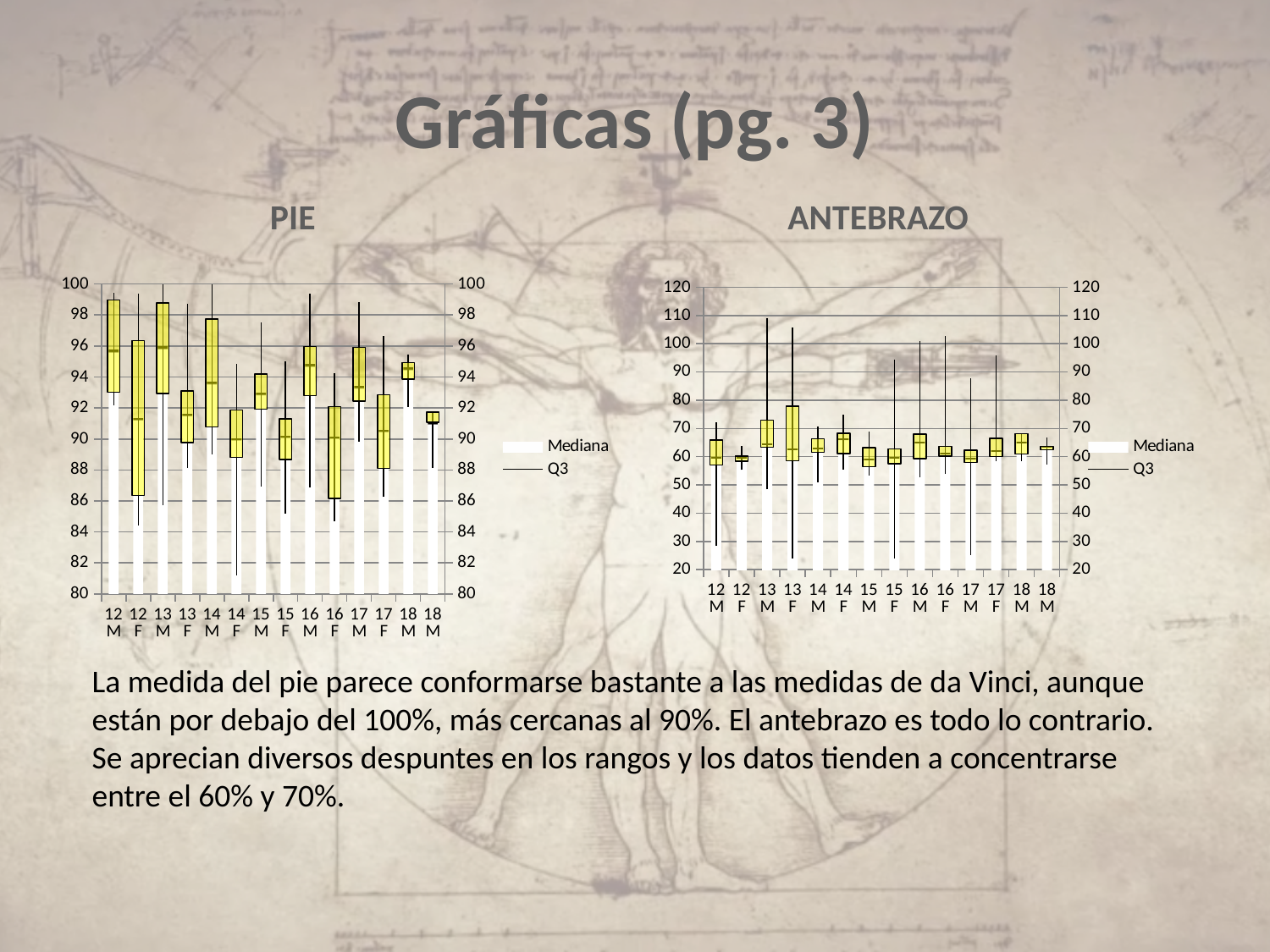
In the PIE chart, is the Mediana value for 14 F greater or less than 92? less What kind of chart is the PIE chart? bar chart In the ANTEBRAZO chart, is the Mediana value for 12 F greater or less than 70? less In the ANTEBRAZO chart, how many categories are shown on the x axis? 14 In the PIE chart, how many series does the legend list? 2 In the ANTEBRAZO chart, which has the larger Mediana value, 13 M or 12 F? 13 M In the ANTEBRAZO chart, is the Mediana value for 13 M greater or less than 50? greater What is the title of the left chart? PIE What is the title of the right chart? ANTEBRAZO In the PIE chart, which has the larger Mediana value, 12 M or 12 F? 12 M In the PIE chart, how many categories are shown on the x axis? 14